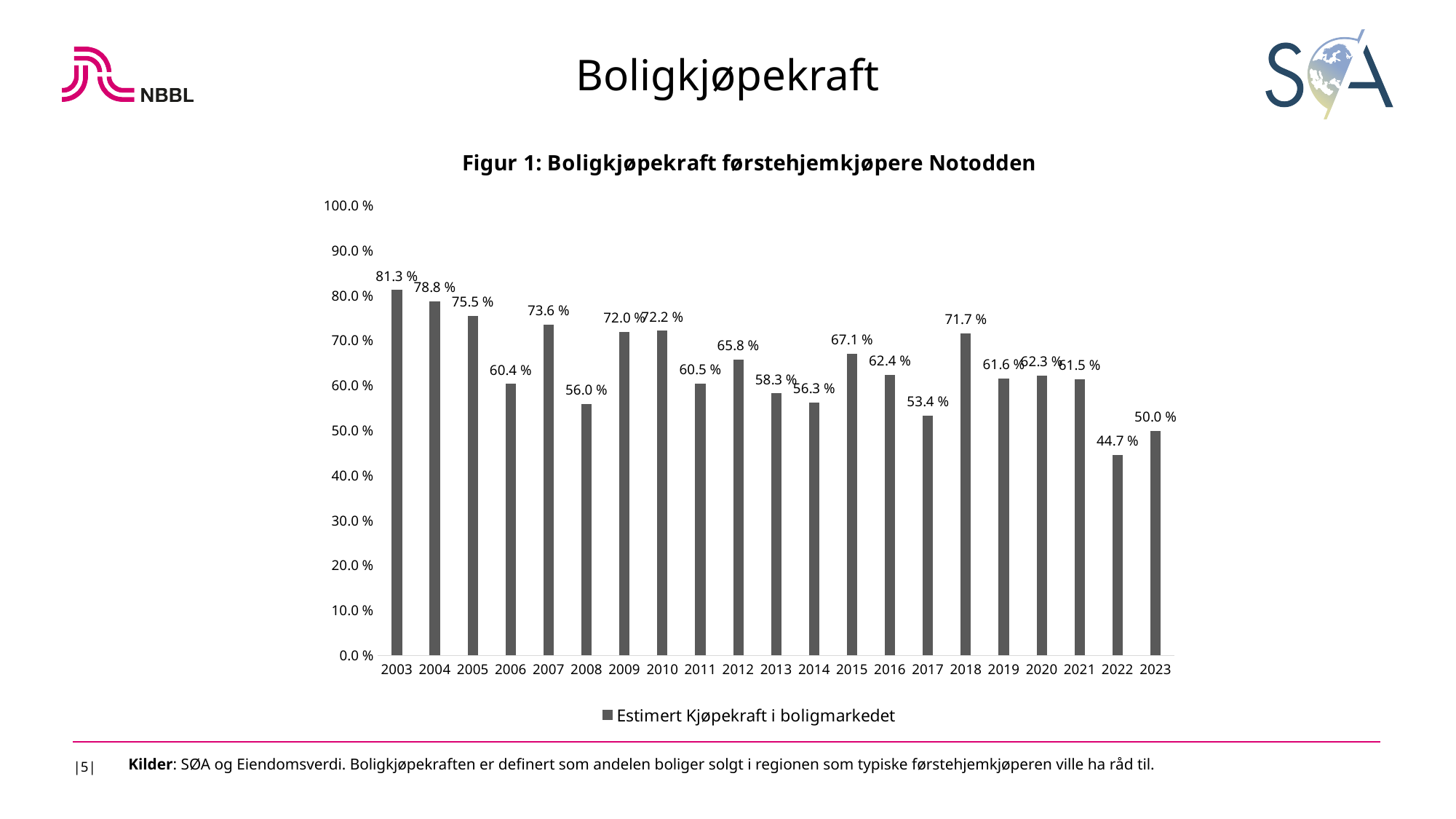
Is the value for 2017 greater or less than 60.0 %? less What is the value for 2003? 81.3 % What is the title of the chart? Figur 1: Boligkjøpekraft førstehjemkjøpere Notodden What is the value for 2018? 71.7 % How many series does the legend list? 1 Which year has the highest value? 2003 What is the difference between the values for 2003 and 2023? 31.3 % What is the value for 2022? 44.7 % What kind of chart is shown? bar chart Which year has the lowest value? 2022 Which is larger, the value for 2008 or the value for 2014? 2014 How many years are shown on the x axis? 21